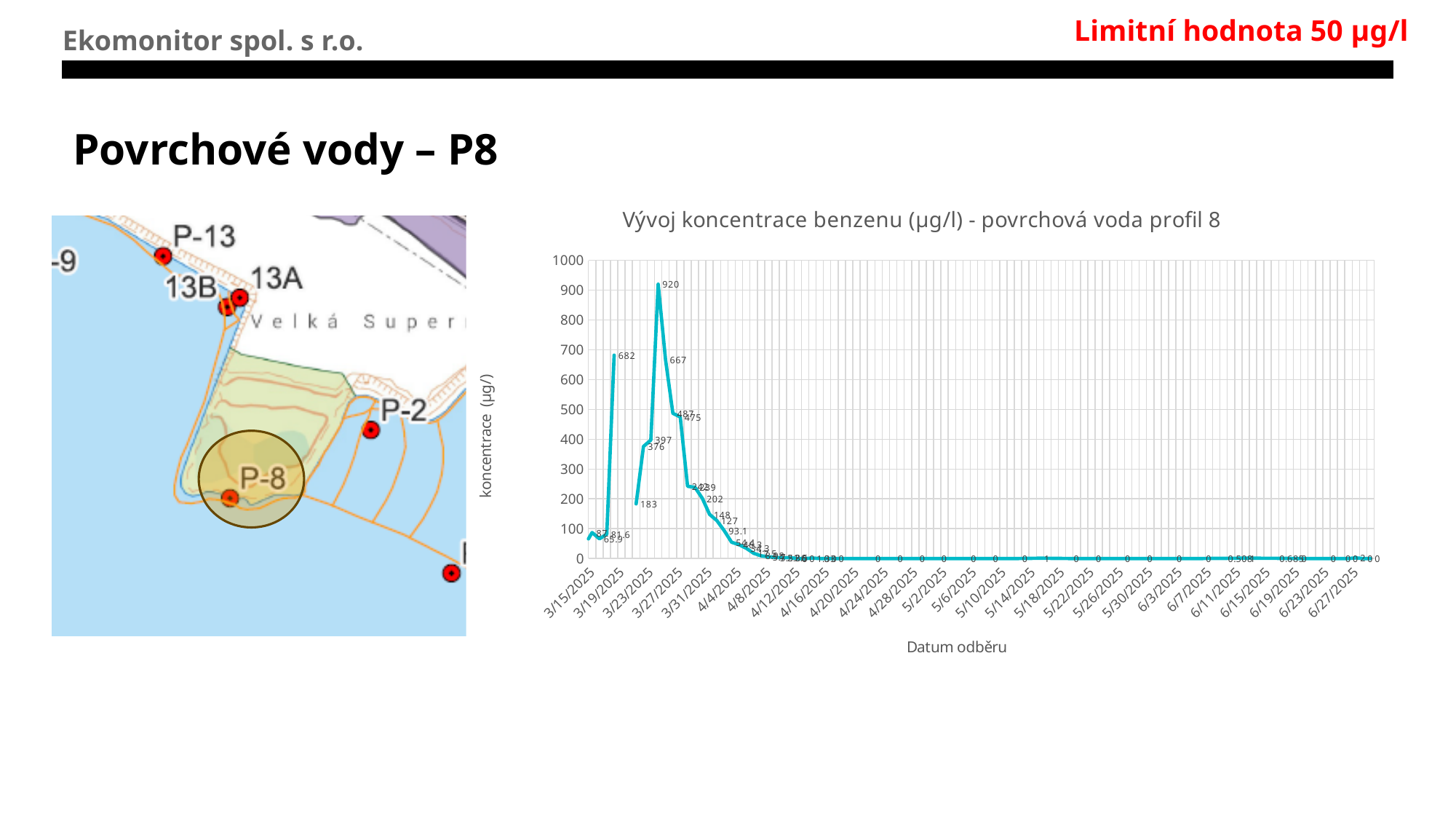
Do the benzene concentration values rise or fall along the x axis after the peak in late March 2025? fall Is the peak value of the chart greater or less than 900? greater Are the values from mid-April 2025 onward greater or less than 100? less What is the maximum value shown on the y axis of the chart? 1000 What is the difference between the peak value of 920 and the following labelled value of 667? 253 What is the title of the chart? Vývoj koncentrace benzenu (µg/l) - povrchová voda profil 8 What is the lowest value labelled on the chart? 0 What type of chart is shown on the slide? line chart What is the label of the x axis of the chart? Datum odběru What is the highest benzene concentration value labelled on the chart? 920 What is the difference between the two labelled peaks, 920 and 682? 238 Which labelled peak is larger, 682 or 920? 920